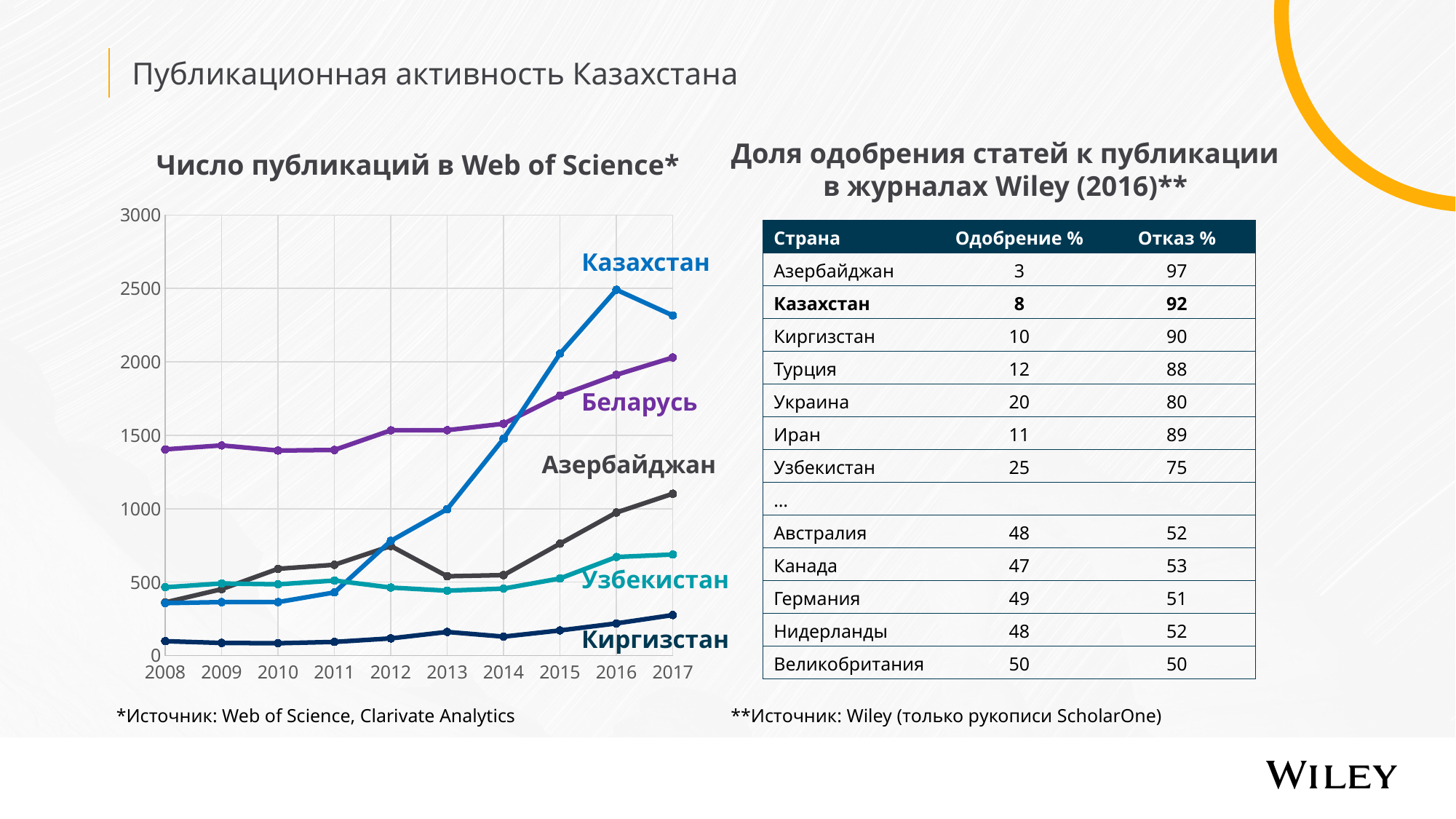
In the chart "Число публикаций в Web of Science*", which country has the lowest number of publications in 2017? Киргизстан In the chart "Число публикаций в Web of Science*", is the value for Киргизстан in 2017 greater or less than 500? less In the chart "Число публикаций в Web of Science*", which country has the highest number of publications in 2017? Казахстан In the chart "Число публикаций в Web of Science*", does the line for Казахстан generally rise or fall from 2008 to 2017? rise In the chart "Число публикаций в Web of Science*", is the value for Беларусь in 2008 greater or less than 1500? less In the chart "Число публикаций в Web of Science*", which is larger in 2017: Беларусь or Азербайджан? Беларусь What kind of chart is "Число публикаций в Web of Science*"? line chart In the chart "Число публикаций в Web of Science*", what colour is the line for Казахстан? blue In the chart "Число публикаций в Web of Science*", is the value for Казахстан in 2017 greater or less than 2000? greater In the chart "Число публикаций в Web of Science*", which country has the highest number of publications in 2008? Беларусь How many countries (series) are plotted in the chart "Число публикаций в Web of Science*"? 5 How many years are shown on the x axis of the chart "Число публикаций в Web of Science*"? 10